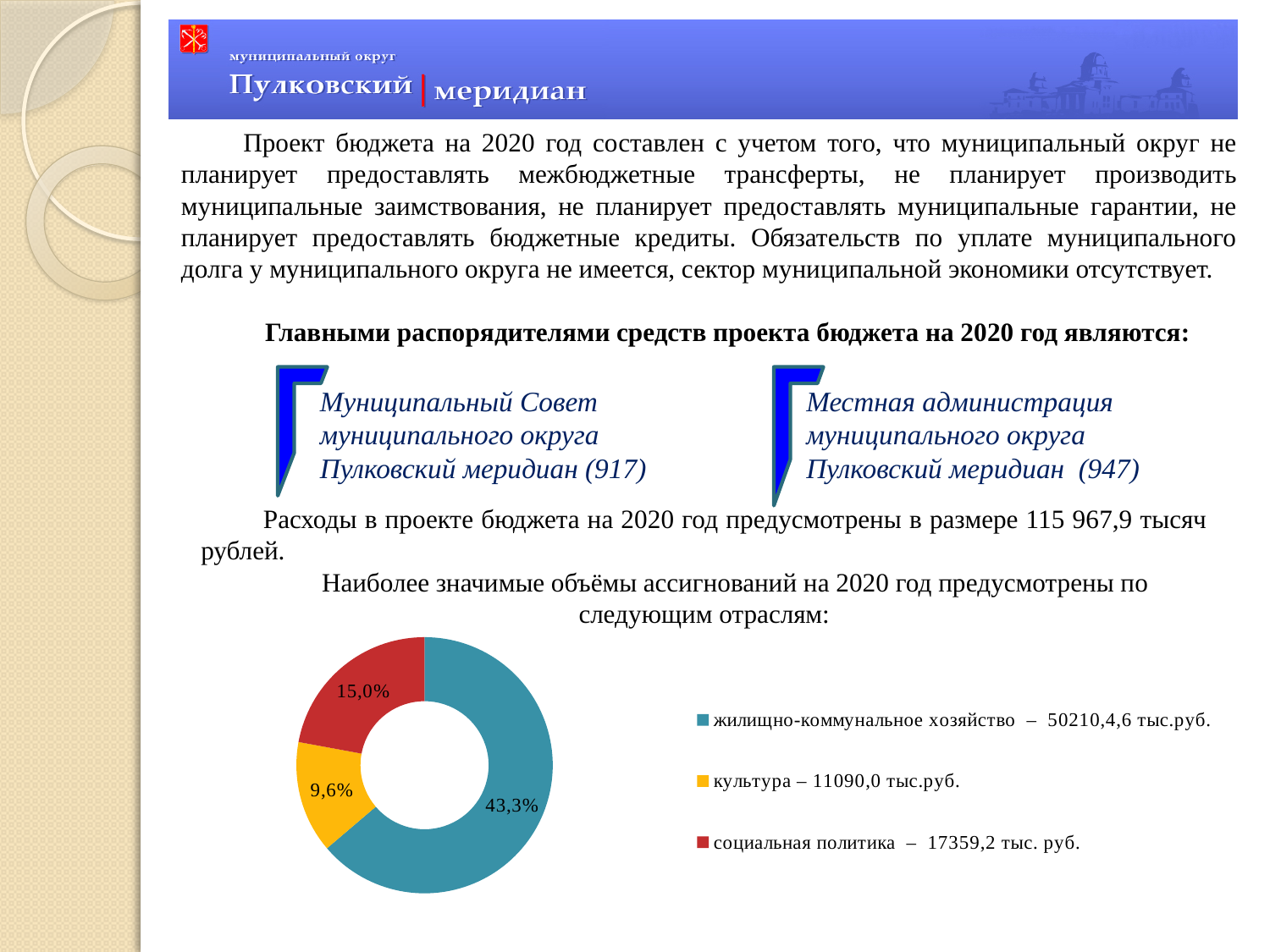
How many slices does the doughnut chart have? 3 According to the legend, what amount is given for социальная политика? 17359,2 тыс. руб. How many entries does the legend of the doughnut chart list? 3 What percentage is shown for the культура slice of the doughnut chart? 9,6% What percentage is shown for the жилищно-коммунальное хозяйство slice of the doughnut chart? 43,3% According to the legend, what amount in тыс.руб. is given for культура? 11090,0 тыс.руб. Which category has the smallest slice in the doughnut chart? культура Which slice is larger in the doughnut chart: социальная политика or культура? социальная политика What percentage is shown for the социальная политика slice of the doughnut chart? 15,0% Which category has the largest slice in the doughnut chart? жилищно-коммунальное хозяйство What colour is the социальная политика slice in the doughnut chart? red What type of chart is shown on the slide? doughnut (pie) chart